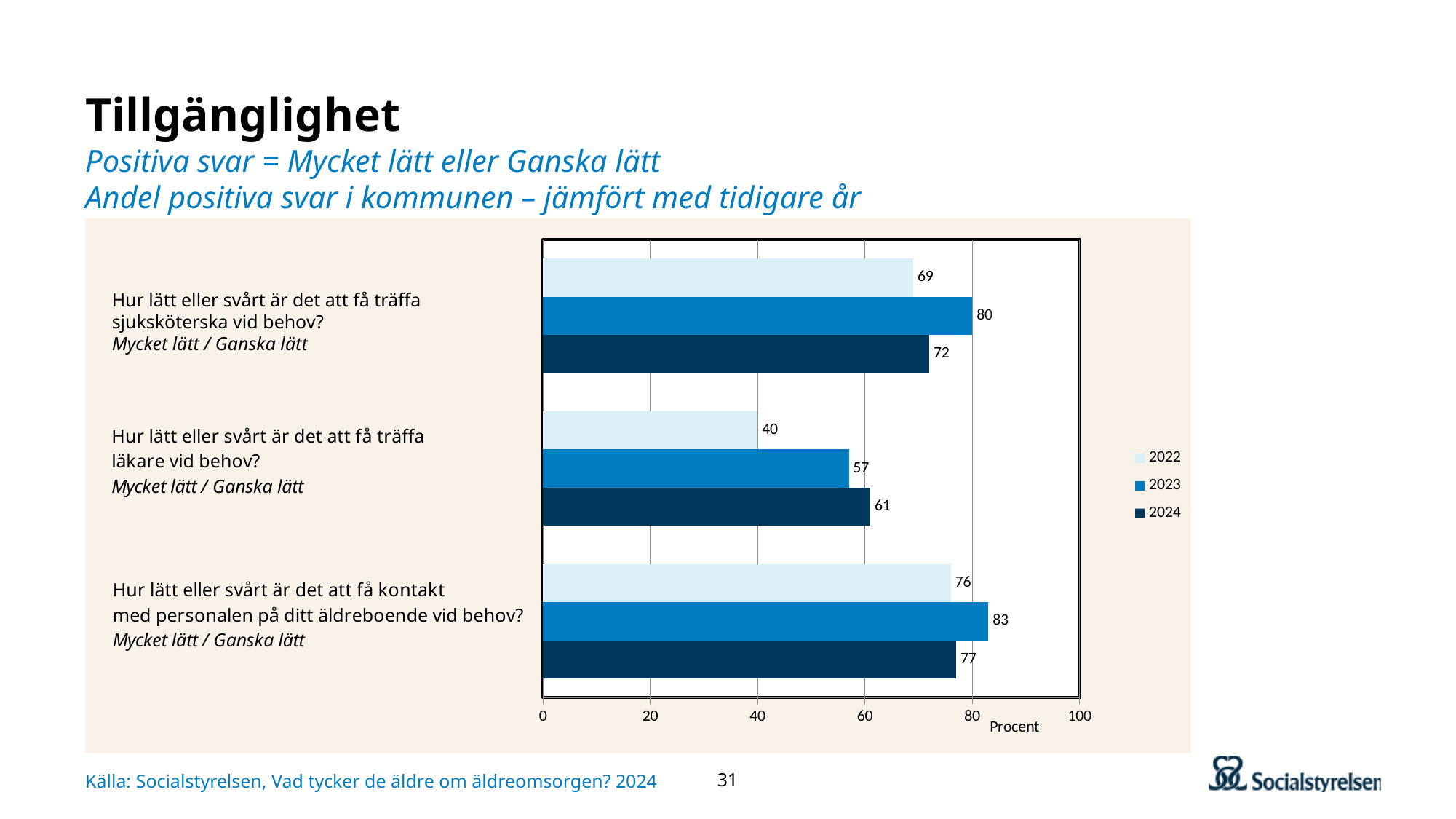
What kind of chart is shown on the slide? Bar chart How many series does the legend list? 3 What is the 2023 value for 'Hur lätt eller svårt är det att få träffa sjuksköterska vid behov?' 80 What is the 2024 value for 'Hur lätt eller svårt är det att få kontakt med personalen på ditt äldreboende vid behov?' 77 How many questions (categories) are shown in the chart? 3 For 'Hur lätt eller svårt är det att få träffa sjuksköterska vid behov?', which year has the larger value, 2022 or 2024? 2024 What is the 2022 value for 'Hur lätt eller svårt är det att få träffa läkare vid behov?' 40 Which question has the highest 2023 value? Hur lätt eller svårt är det att få kontakt med personalen på ditt äldreboende vid behov? What is the difference between the 2023 and 2022 values for 'Hur lätt eller svårt är det att få träffa läkare vid behov?' 17 What is the label of the horizontal axis? Procent Which year is shown with the darkest blue bars in the legend? 2024 Which question has the lowest 2022 value? Hur lätt eller svårt är det att få träffa läkare vid behov?